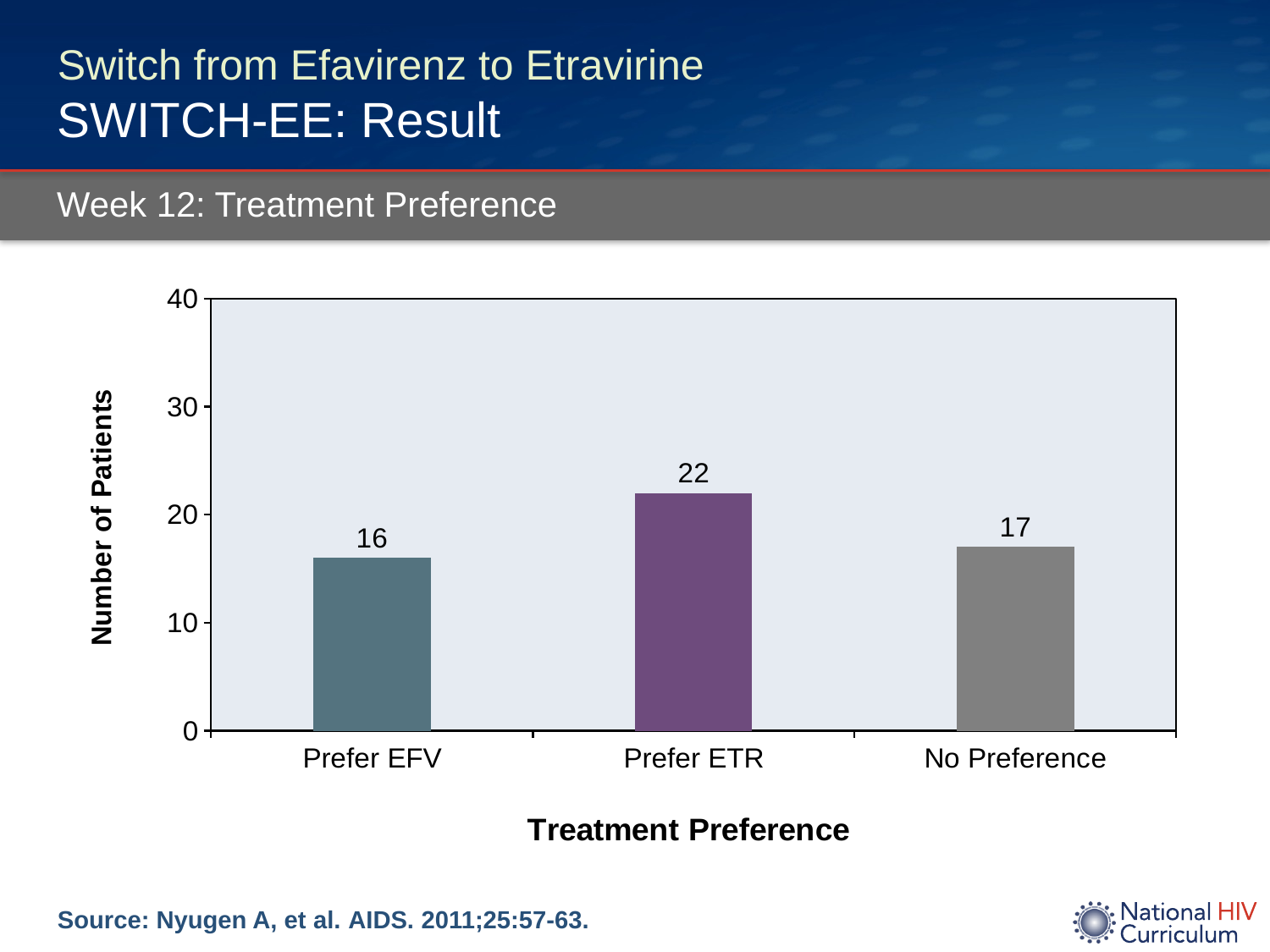
What is the difference in number of patients between Prefer ETR and Prefer EFV? 6 What kind of chart is shown on the slide? Bar chart Which treatment preference category has the highest number of patients? Prefer ETR Which has more patients, Prefer ETR or No Preference? Prefer ETR How many treatment preference categories are shown on the chart? 3 How many patients preferred ETR? 22 How many patients had no preference? 17 What is the difference in number of patients between No Preference and Prefer EFV? 1 How many patients preferred EFV? 16 What is the label of the y axis of the chart? Number of Patients Is the number of patients who prefer ETR greater or less than 20? greater Which treatment preference category has the lowest number of patients? Prefer EFV